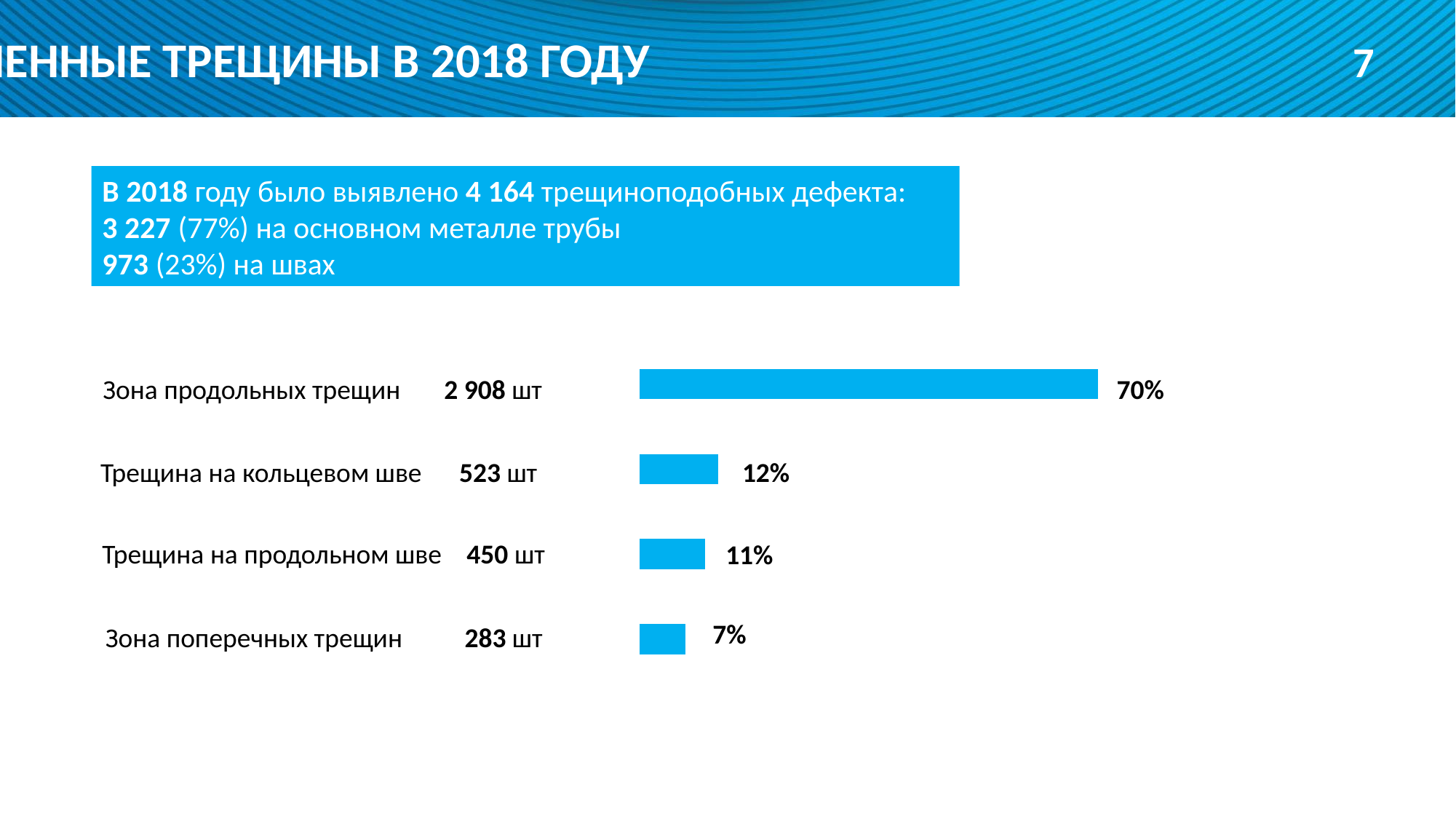
Which category has the lowest percentage? Зона поперечных трещин What is the difference in count between Трещина на кольцевом шве and Трещина на продольном шве? 73 шт What is the difference in percentage points between Зона продольных трещин and Трещина на кольцевом шве? 58% Which is larger: the percentage for Трещина на кольцевом шве or for Трещина на продольном шве? Трещина на кольцевом шве What percentage is shown for Зона продольных трещин? 70% How many categories are shown in the bar chart? 4 Which category has the highest percentage? Зона продольных трещин What percentage is shown for Трещина на продольном шве? 11% How many defects (шт) are listed for Трещина на кольцевом шве? 523 шт Do the bar values increase or decrease from the top category to the bottom category? Decrease How many defects (шт) are listed for Зона поперечных трещин? 283 шт What type of chart is shown on the slide? Bar chart